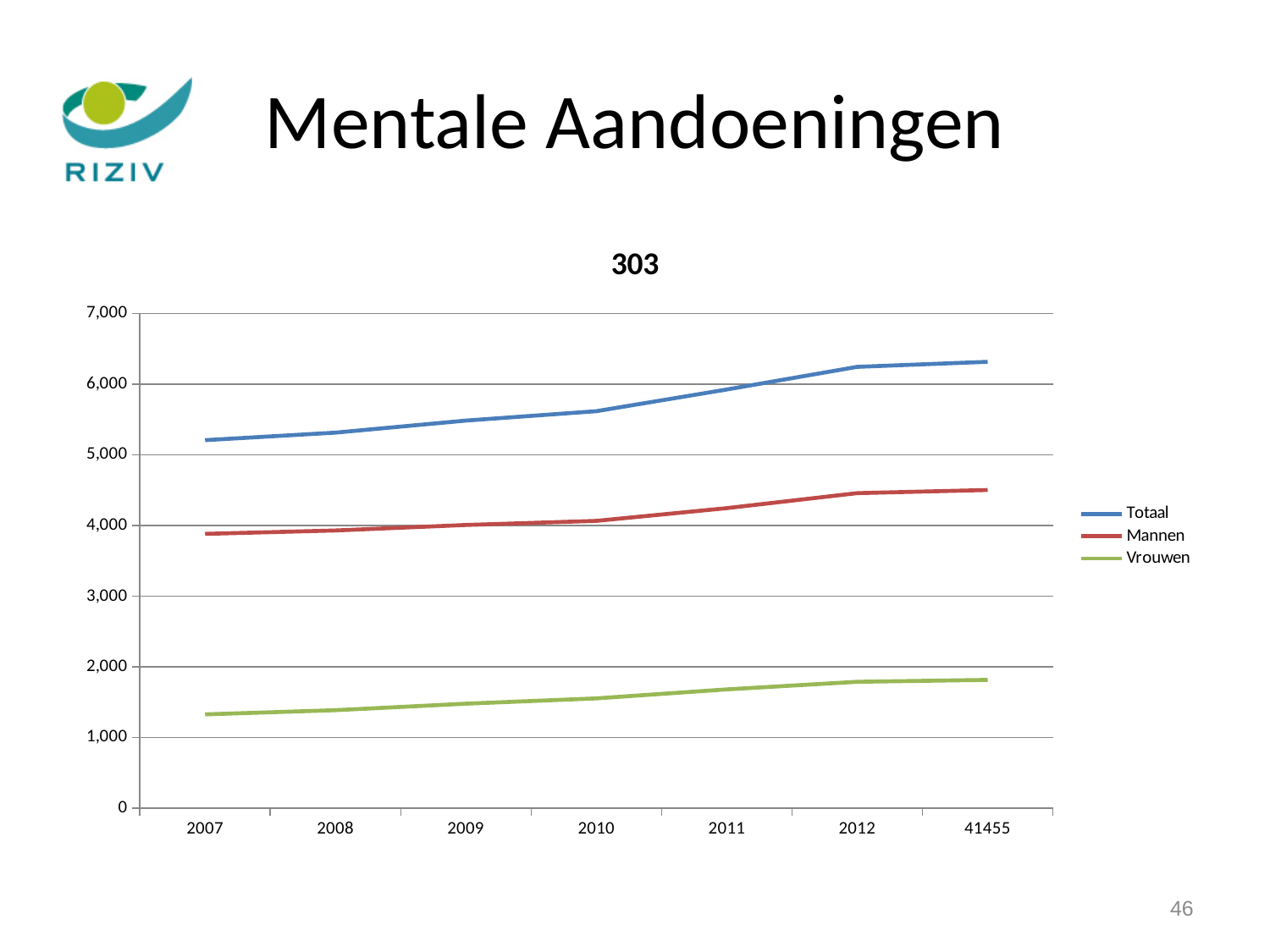
Is the value for Totaal in 2007 greater or less than 5,000? greater What kind of chart is shown on the slide? line chart Is the value for Mannen in 2007 greater or less than 4,000? less How many series does the legend list? 3 Which series has the lowest values across all years? Vrouwen Which series are listed in the legend? Totaal, Mannen, Vrouwen Does the Totaal series rise or fall from 2007 to 2012? rise What is the title of the chart? 303 Is the value for Totaal in 2012 greater or less than 6,000? greater How many points are plotted along the x axis for each series? 7 Does the Vrouwen series rise or fall along the x axis? rise